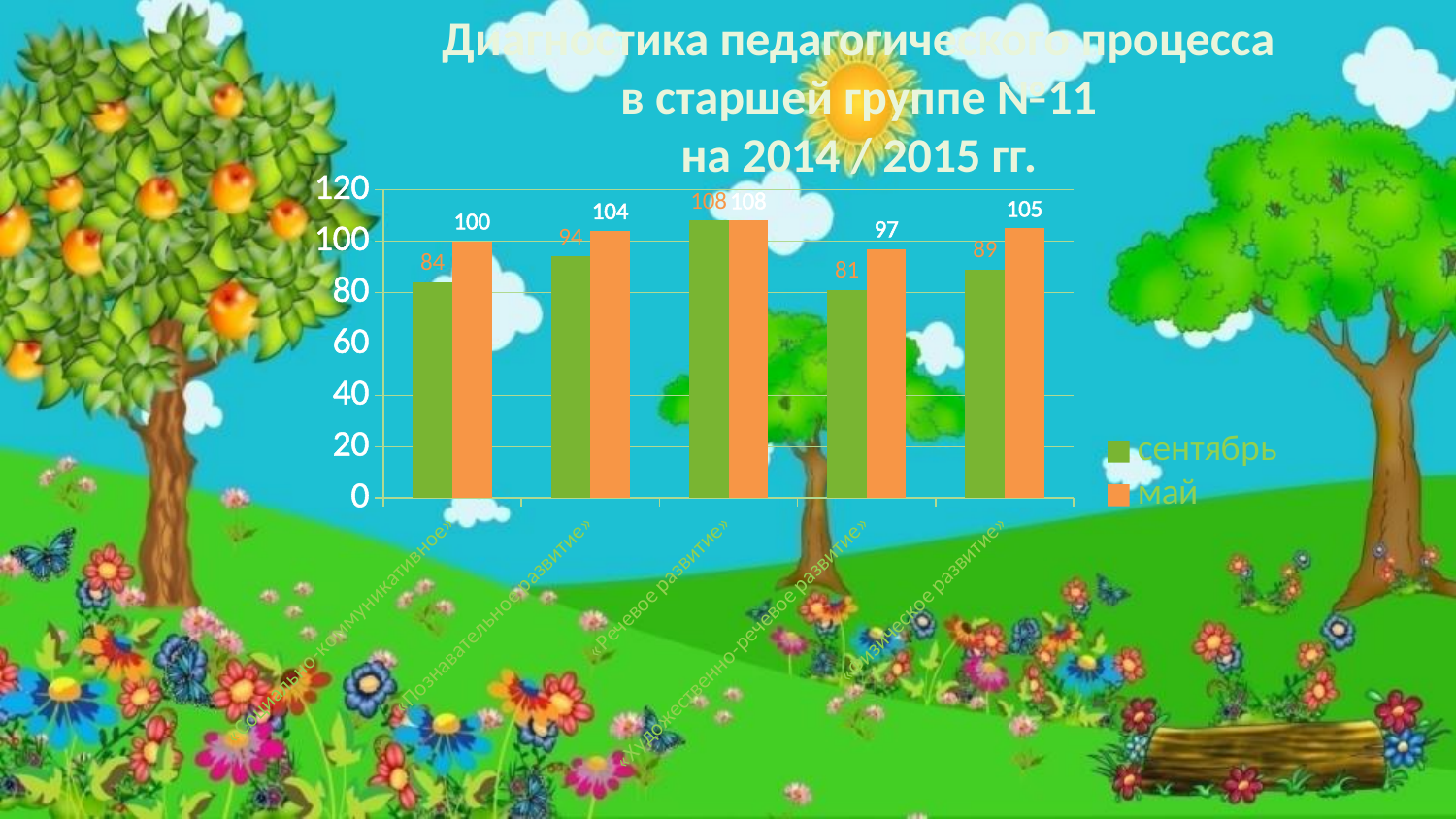
Which is larger, the сентябрь value for «Познавательное развитие» or for «Физическое развитие»? «Познавательное развитие» What are the two series named in the legend? сентябрь and май What is the lowest сентябрь value shown on the chart? 81 What is the май value for «Познавательное развитие»? 104 What is the difference between the май and сентябрь values for «Познавательное развитие»? 10 How many series does the legend list? 2 How many categories are plotted on the x axis? 5 Which category has the highest май value? «Речевое развитие» What is the сентябрь value for «Речевое развитие»? 108 What is the difference between the май and сентябрь values for «Физическое развитие»? 16 What kind of chart is shown on the slide? bar chart What is the сентябрь value for «Физическое развитие»? 89